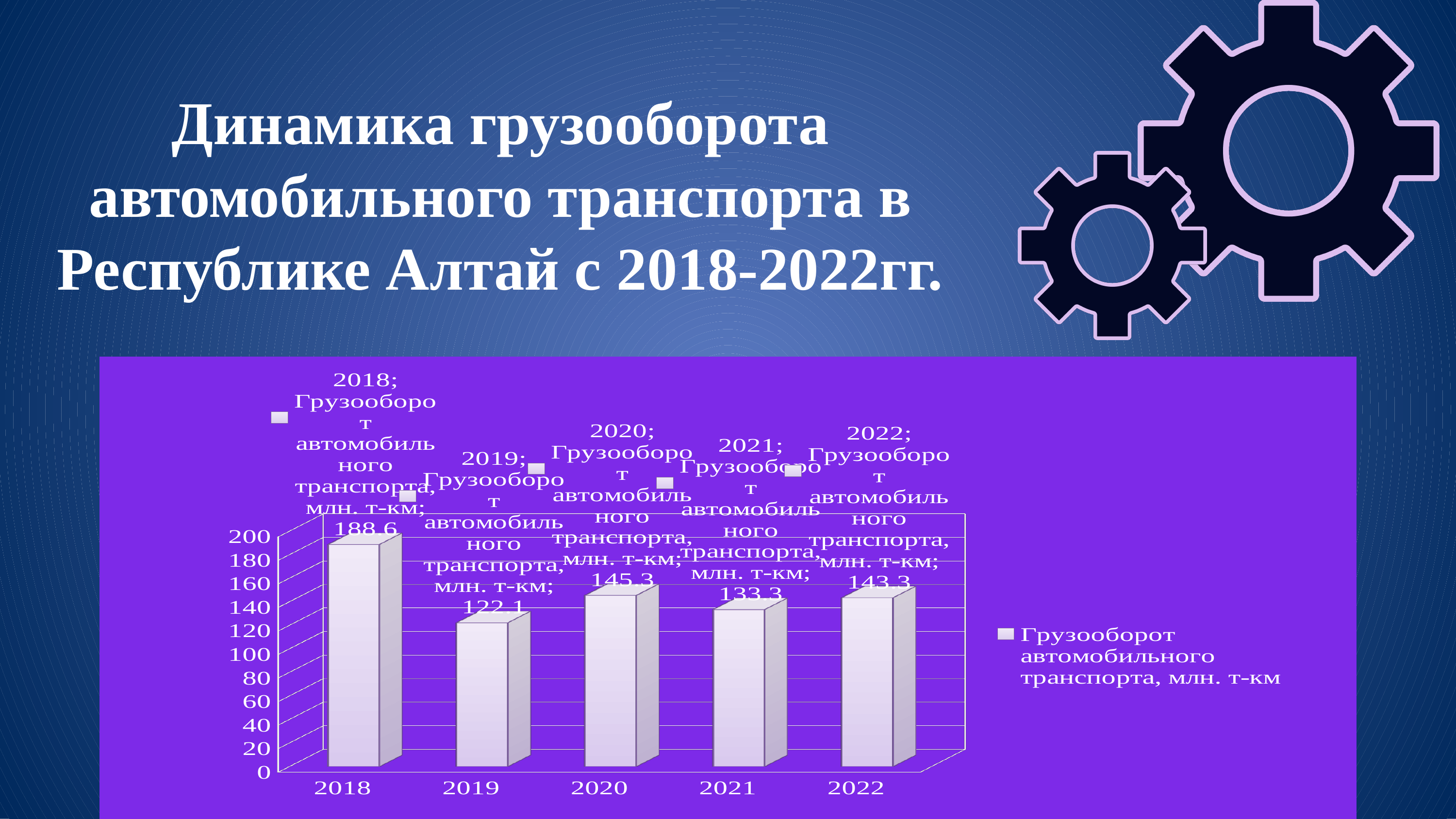
What is the value for 2021? 133.3 Which year has the highest value? 2018 What is the difference between the values for 2020 and 2022? 2.0 How many years are shown on the x axis? 5 What kind of chart is shown on the slide? bar chart What is the value for 2019? 122.1 What series does the legend list? Грузооборот автомобильного транспорта, млн. т-км What is the difference between the values for 2018 and 2019? 66.5 Which year has the lowest value? 2019 Which is larger, the value for 2020 or the value for 2021? 2020 What is the value for 2018? 188.6 Is the value for 2022 greater or less than 140? greater